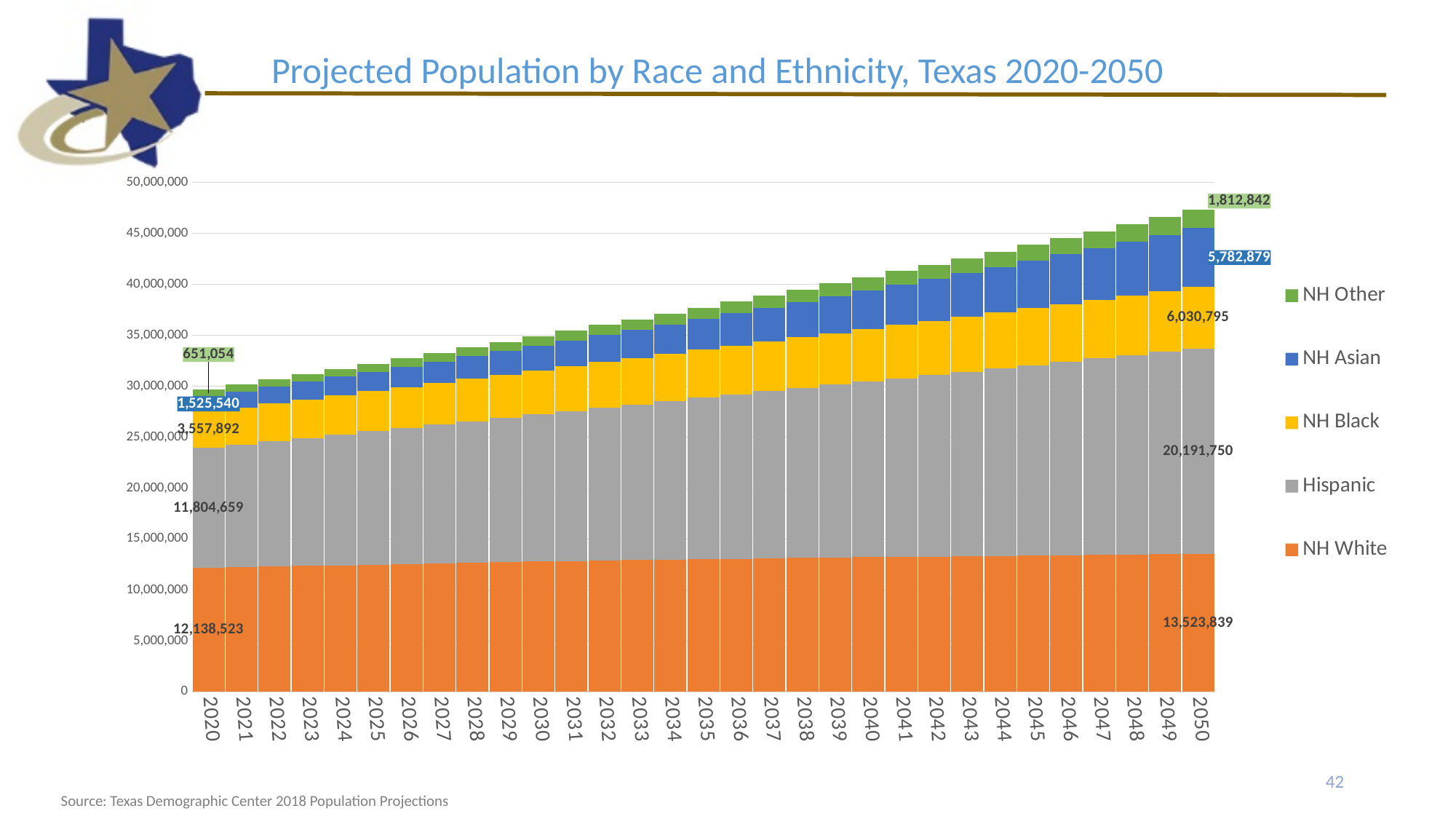
What is the total projected population for 2050? 47,342,105 What kind of chart is shown on the slide? Stacked bar chart By how much does the Hispanic population grow from 2020 to 2050? 8,387,091 In 2020, which is larger: the NH White population or the Hispanic population? NH White What is the NH White population value shown for 2020? 12,138,523 Does the total population rise or fall from 2020 to 2050? Rise Which group has the smallest population in 2020? NH Other How many years are plotted along the x axis? 31 What is the NH Asian population value shown for 2050? 5,782,879 Which group has the largest population in 2050? Hispanic How many series does the legend list? 5 What is the projected Hispanic population in 2050? 20,191,750